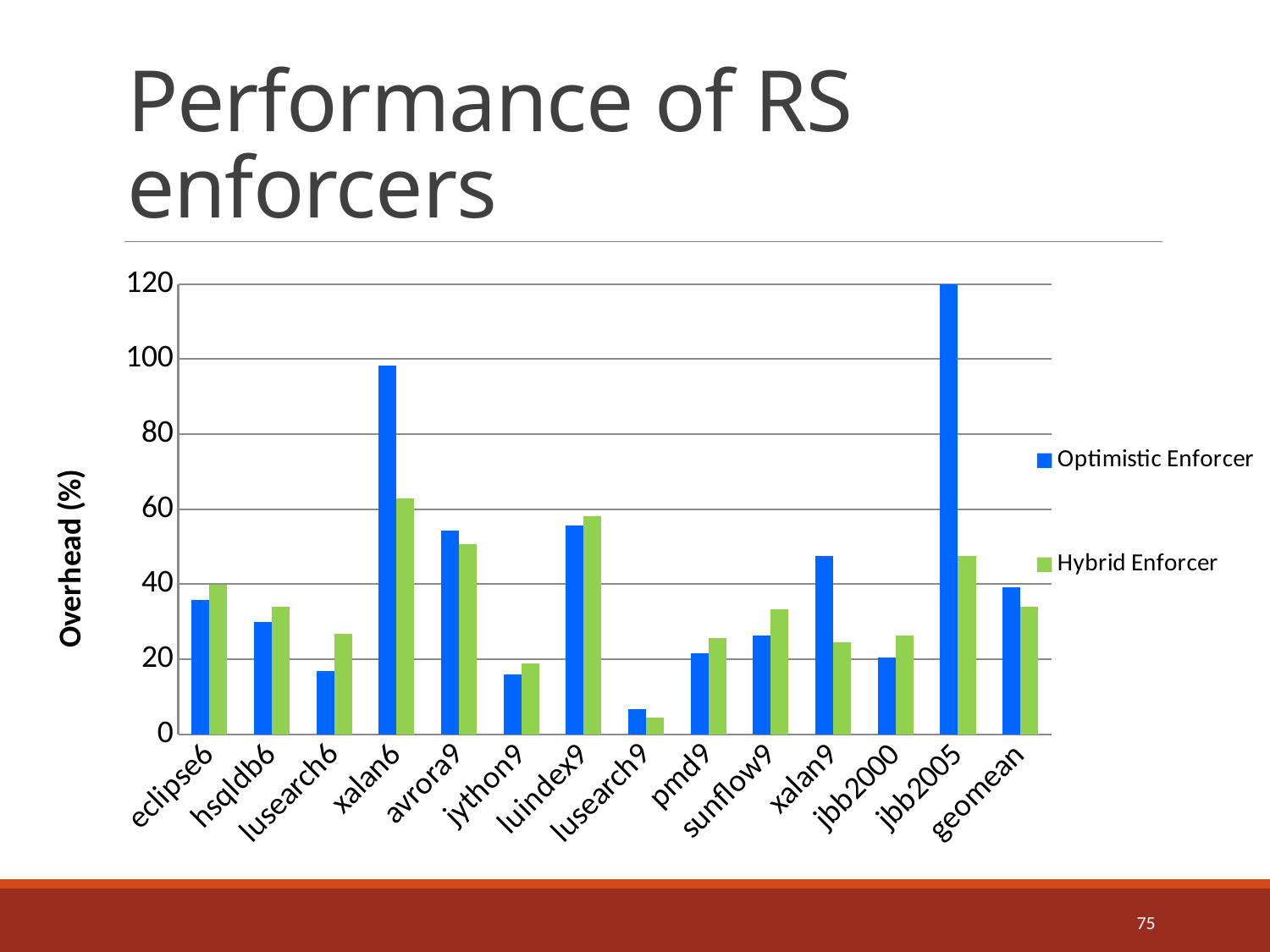
How many series does the legend list? 2 Is the Optimistic Enforcer value for xalan6 greater or less than 80? greater Which category has the highest Optimistic Enforcer overhead? jbb2005 What kind of chart is shown on the slide? bar chart Is the Optimistic Enforcer value for jython9 greater or less than 20? less Which category has the lowest Optimistic Enforcer overhead? lusearch9 For xalan9, which series has the larger overhead, Optimistic Enforcer or Hybrid Enforcer? Optimistic Enforcer How many benchmark categories are shown on the x axis? 14 For lusearch6, which series has the larger overhead, Optimistic Enforcer or Hybrid Enforcer? Hybrid Enforcer Is the Hybrid Enforcer value for lusearch9 greater or less than 20? less Which category has the highest Hybrid Enforcer overhead? xalan6 What is the label of the y axis? Overhead (%)